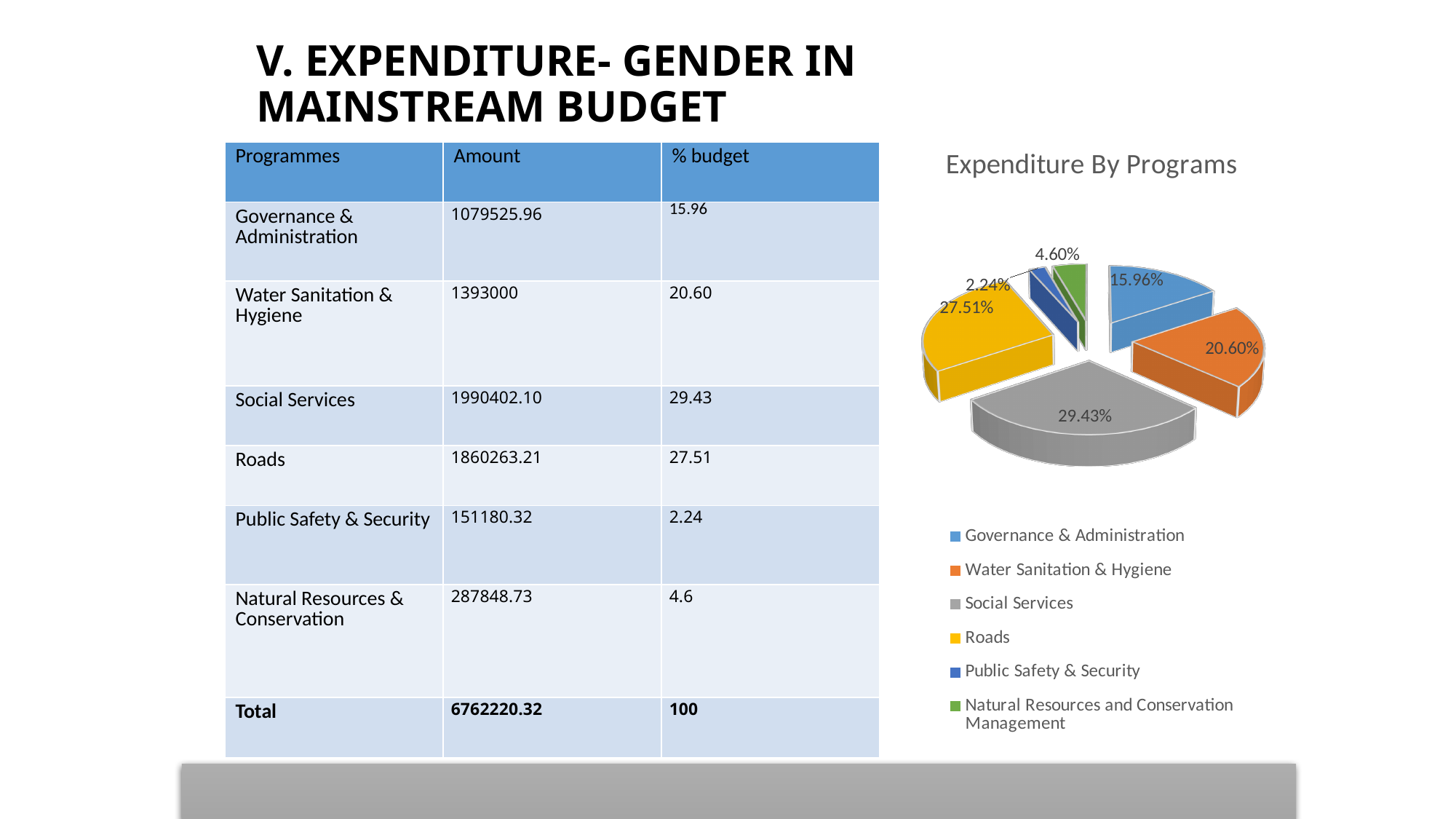
What is the title of the chart? Expenditure By Programs What share of the pie does Social Services have? 29.43% Which programme has the smallest slice of the pie? Public Safety & Security What is the difference between the Social Services share and the Roads share? 1.92% How many slices does the pie chart have? 6 What kind of chart is shown on the slide? pie chart Which programme has the largest slice of the pie? Social Services What is the value shown for Water Sanitation & Hygiene in the pie chart? 20.60% Which is larger in the pie chart, Water Sanitation & Hygiene or Governance & Administration? Water Sanitation & Hygiene How many entries does the chart legend list? 6 What is the value shown for Governance & Administration in the pie chart? 15.96% What share of the pie does Roads have? 27.51%